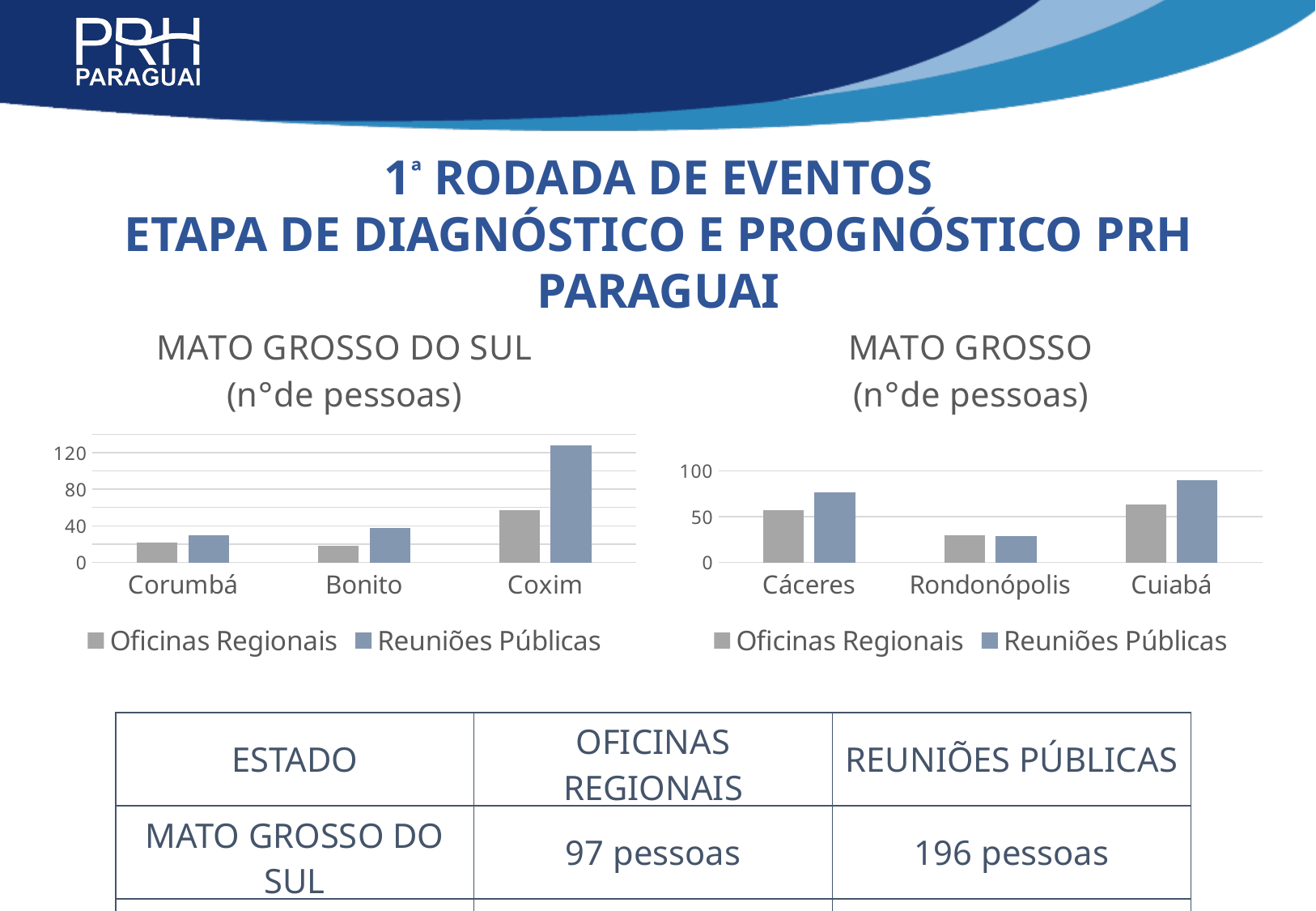
How many series does the legend of the MATO GROSSO DO SUL (n°de pessoas) chart list? 2 How many categories are shown on the x axis of the MATO GROSSO (n°de pessoas) chart? 3 In the MATO GROSSO (n°de pessoas) chart, which is larger for Cuiabá: Oficinas Regionais or Reuniões Públicas? Reuniões Públicas In the MATO GROSSO (n°de pessoas) chart, which category has the lowest Reuniões Públicas value? Rondonópolis What kind of chart is the MATO GROSSO DO SUL (n°de pessoas) chart? bar chart In the MATO GROSSO (n°de pessoas) chart, which category has the highest Oficinas Regionais value? Cuiabá In the MATO GROSSO DO SUL (n°de pessoas) chart, which category has the highest Reuniões Públicas value? Coxim In the MATO GROSSO DO SUL (n°de pessoas) chart, is the Oficinas Regionais value for Bonito greater or less than 40? less In the MATO GROSSO DO SUL (n°de pessoas) chart, which is larger: the Oficinas Regionais value for Coxim or the Oficinas Regionais value for Corumbá? Coxim In the MATO GROSSO DO SUL (n°de pessoas) chart, is the Reuniões Públicas value for Coxim greater or less than 120? greater In the MATO GROSSO (n°de pessoas) chart, is the Reuniões Públicas value for Cáceres greater or less than 50? greater What colour are the Oficinas Regionais bars in the MATO GROSSO (n°de pessoas) chart? grey